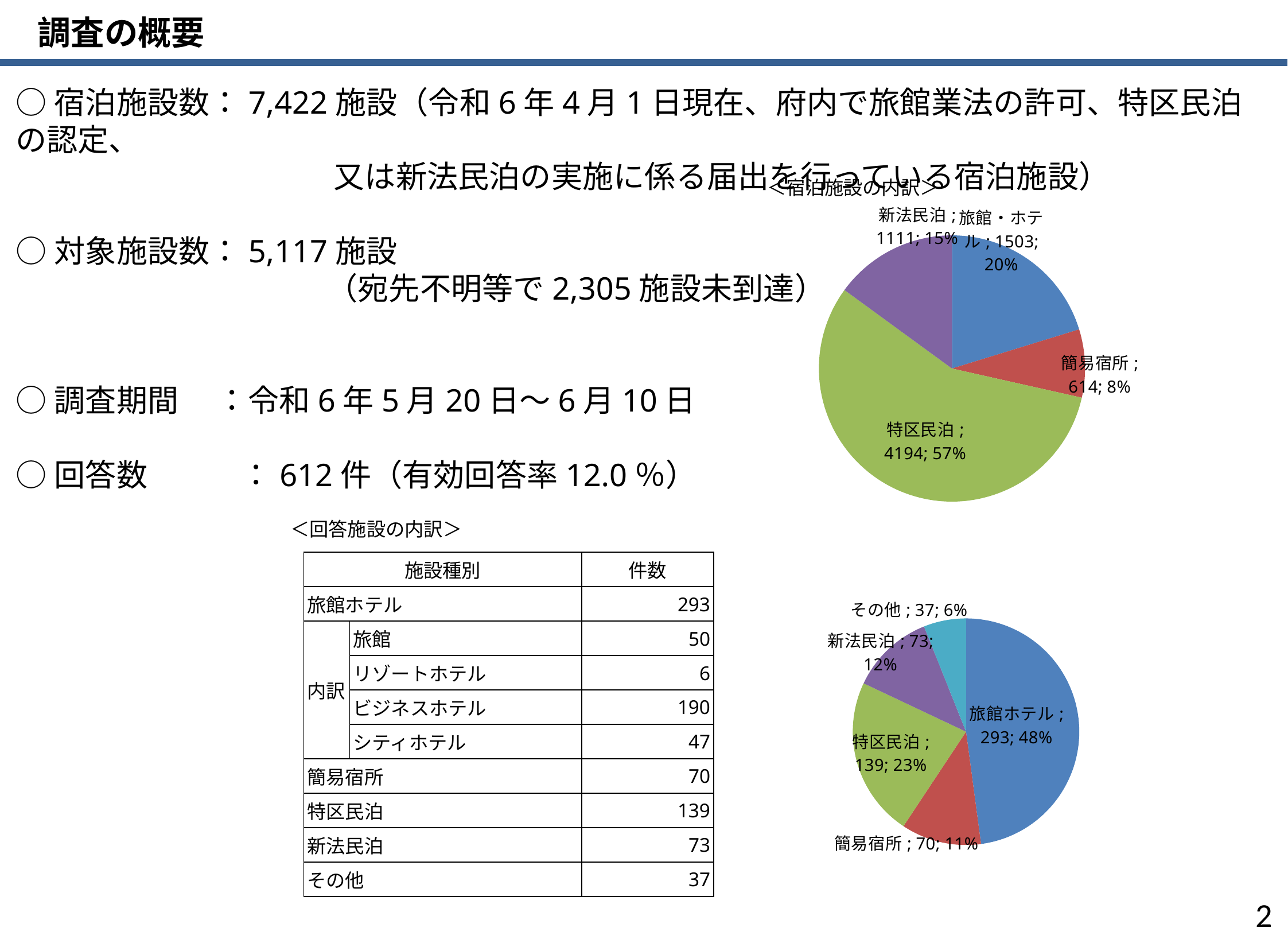
In the top-right pie chart (宿泊施設の内訳), how many slices are there? 4 In the top-right pie chart (宿泊施設の内訳), what share of the pie does 旅館・ホテル represent? 20% In the bottom-right pie chart, which category has the smallest slice? その他 What type of chart is the top-right chart on the slide? pie chart In the top-right pie chart (宿泊施設の内訳), what is the value for 特区民泊? 4194 In the bottom-right pie chart, how many slices are there? 5 In the top-right pie chart (宿泊施設の内訳), what is the difference between the values for 旅館・ホテル and 新法民泊? 392 In the top-right pie chart (宿泊施設の内訳), which category has the smallest slice? 簡易宿所 In the bottom-right pie chart, what is the value for 特区民泊? 139 In the top-right pie chart (宿泊施設の内訳), which category has the largest slice? 特区民泊 In the bottom-right pie chart, which is larger, 簡易宿所 or 新法民泊? 新法民泊 In the bottom-right pie chart, what share of the pie does 旅館ホテル represent? 48%